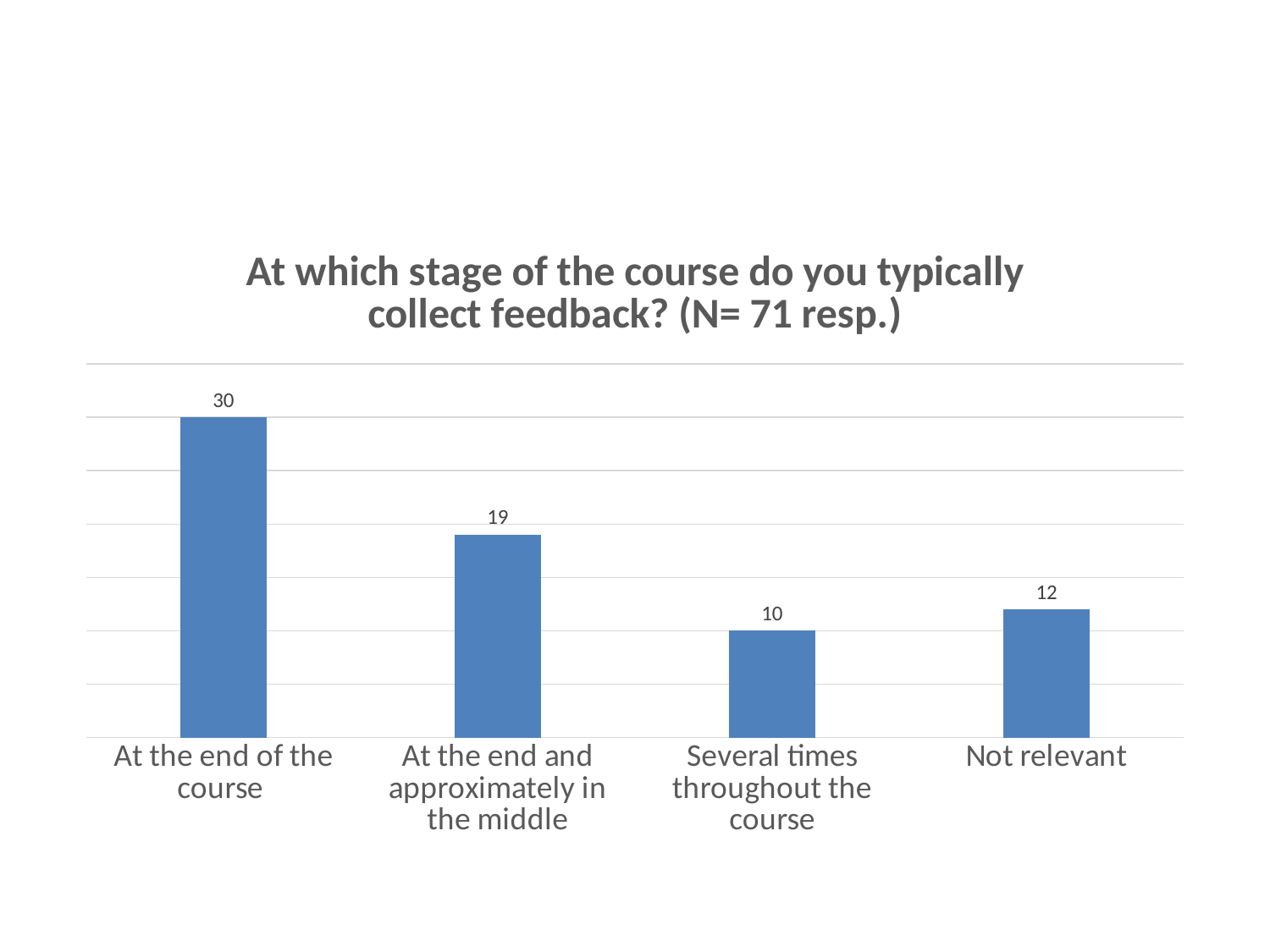
Which category has the lowest value? Several times throughout the course What kind of chart is shown on the slide? Bar chart What is the title of the chart? At which stage of the course do you typically collect feedback? (N= 71 resp.) Which category has the highest value? At the end of the course What is the value for "At the end and approximately in the middle"? 19 What is the value for "Not relevant"? 12 What is the difference between the values for "At the end of the course" and "At the end and approximately in the middle"? 11 Which is larger, the value for "Not relevant" or the value for "Several times throughout the course"? Not relevant What is the difference between the values for "Not relevant" and "Several times throughout the course"? 2 What is the value for "At the end of the course"? 30 How many categories are shown in the chart? 4 What is the value for "Several times throughout the course"? 10